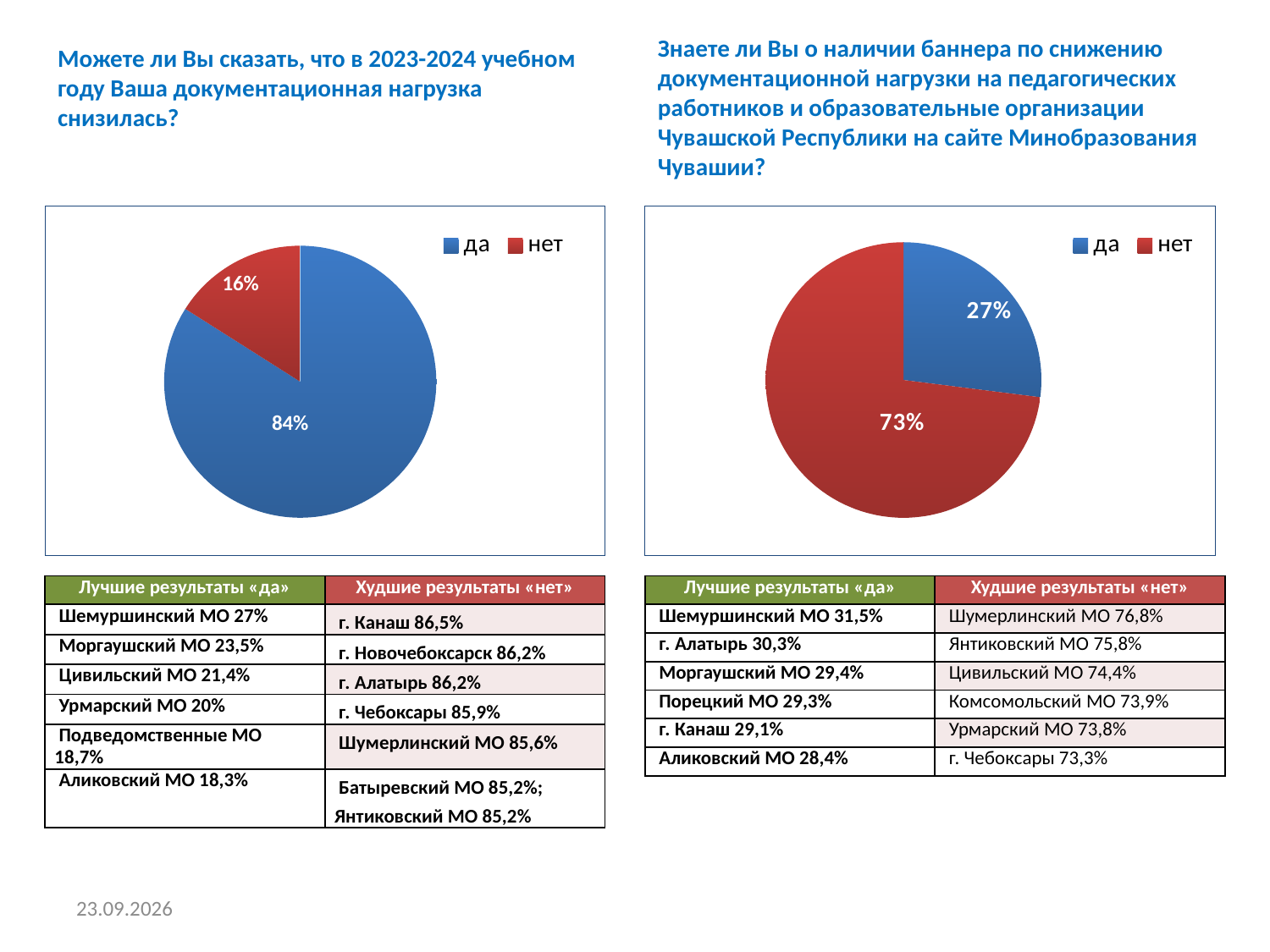
What type of chart is used on the left side of the slide? pie chart In the right pie chart, what share is shown for «нет»? 73% In the left pie chart, which colour represents «нет»? red In the left pie chart, what share is shown for «нет»? 16% In the right pie chart, which slice is the smallest? да In the left pie chart, which slice is the largest? да In the left pie chart, what is the difference between the «да» and «нет» shares? 68% How many slices does the right pie chart have? 2 In the right pie chart, what share is shown for «да»? 27% In the left pie chart, what share is shown for «да»? 84% In the right pie chart, what is the difference between the «нет» and «да» shares? 46% In the right pie chart, which is larger, «да» or «нет»? нет